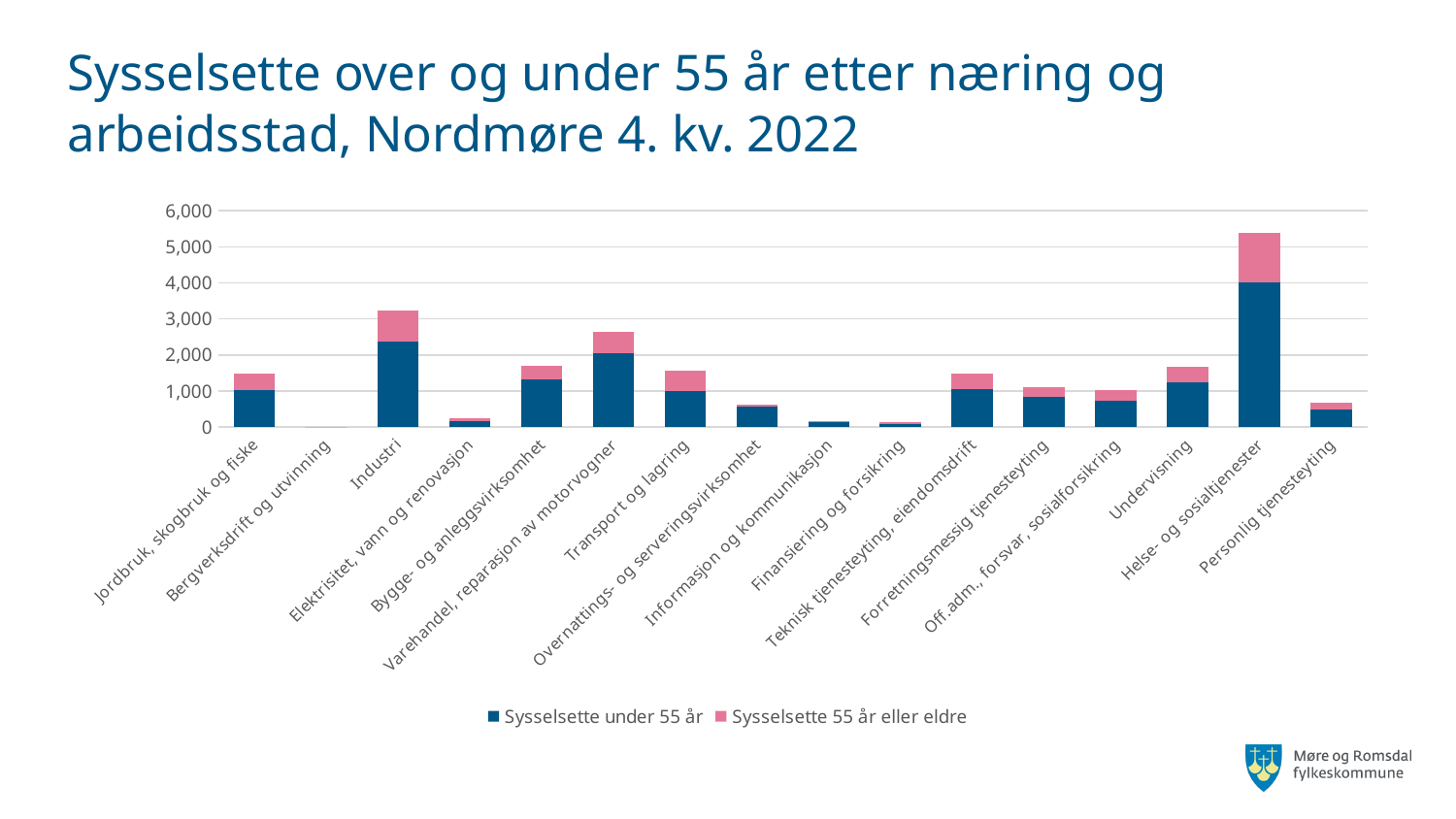
Is the total bar for Personlig tjenesteyting greater or less than 1,000? less Is the total bar for Industri greater or less than 3,000? greater Which industry has the highest total number of employed persons? Helse- og sosialtjenester Which has a larger total bar, Industri or Varehandel, reparasjon av motorvogner? Industri Is the total bar for Helse- og sosialtjenester greater or less than 5,000? greater Which industry has the lowest total number of employed persons? Bergverksdrift og utvinning How many industry categories are shown on the x axis? 16 How many series does the legend list? 2 What are the two series listed in the legend? Sysselsette under 55 år; Sysselsette 55 år eller eldre What kind of chart is shown on the slide? Stacked bar chart Which series is shown in dark blue? Sysselsette under 55 år